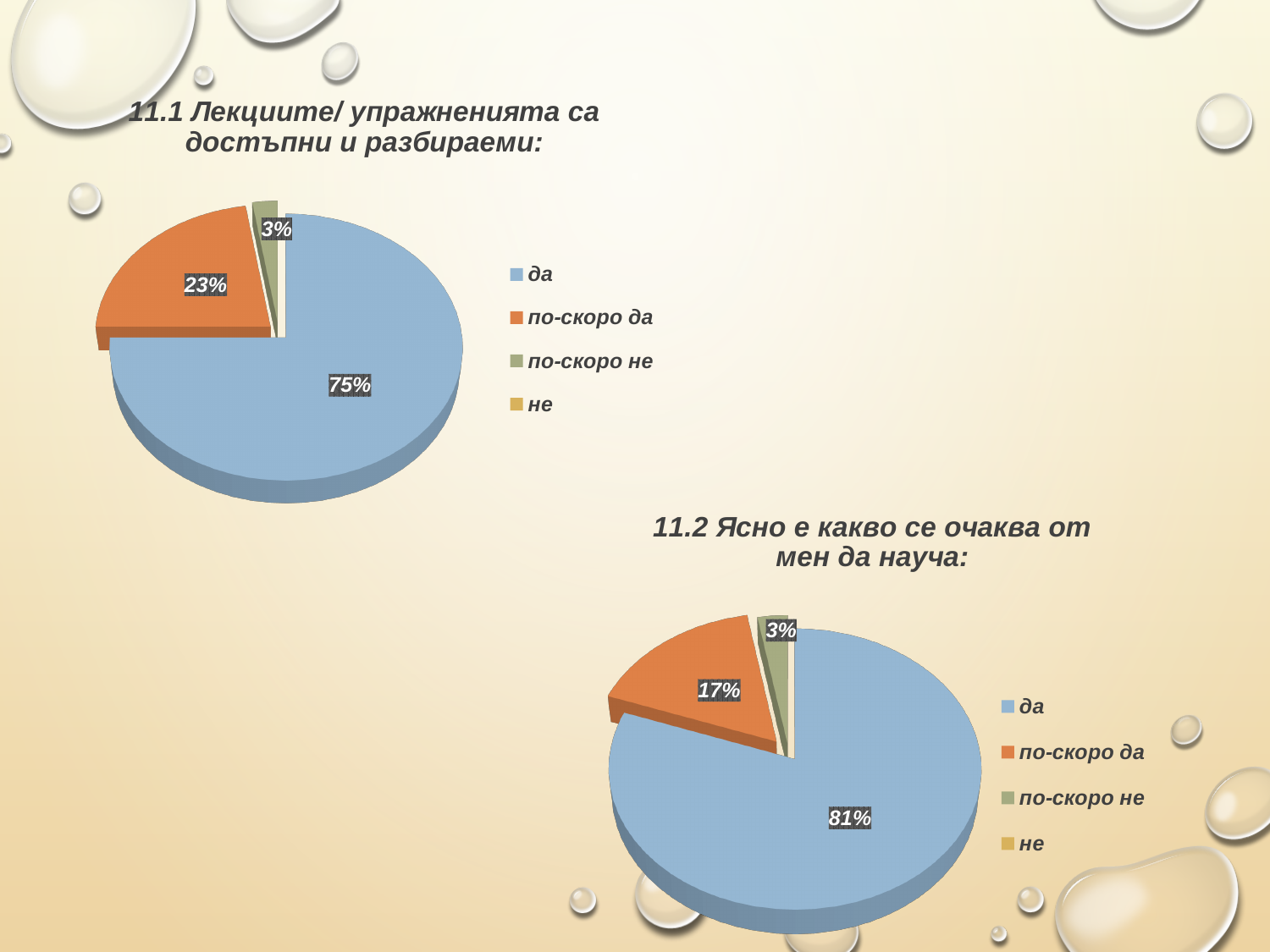
In the chart titled "11.2 Ясно е какво се очаква от мен да науча:", which category has the largest slice? да In the chart titled "11.1 Лекциите/ упражненията са достъпни и разбираеми:", what percentage is shown for "по-скоро да"? 23% Which chart has the larger share for "да": the chart titled "11.1" or the chart titled "11.2"? 11.2 What type of chart is used for "11.2 Ясно е какво се очаква от мен да науча:"? pie chart In the chart titled "11.1 Лекциите/ упражненията са достъпни и разбираеми:", what percentage is shown for "да"? 75% How many entries does the legend of the chart titled "11.1 Лекциите/ упражненията са достъпни и разбираеми:" list? 4 In the chart titled "11.1 Лекциите/ упражненията са достъпни и разбираеми:", which labelled category has the smallest slice? по-скоро не In the chart titled "11.2 Ясно е какво се очаква от мен да науча:", what percentage is shown for "да"? 81% In the chart titled "11.2 Ясно е какво се очаква от мен да науча:", what percentage is shown for "по-скоро да"? 17% In the chart titled "11.2 Ясно е какво се очаква от мен да науча:", what is the difference in percentage points between "да" and "по-скоро да"? 64 In the chart titled "11.1 Лекциите/ упражненията са достъпни и разбираеми:", what is the difference in percentage points between "да" and "по-скоро да"? 52 In the chart titled "11.1 Лекциите/ упражненията са достъпни и разбираеми:", what percentage is shown for "по-скоро не"? 3%